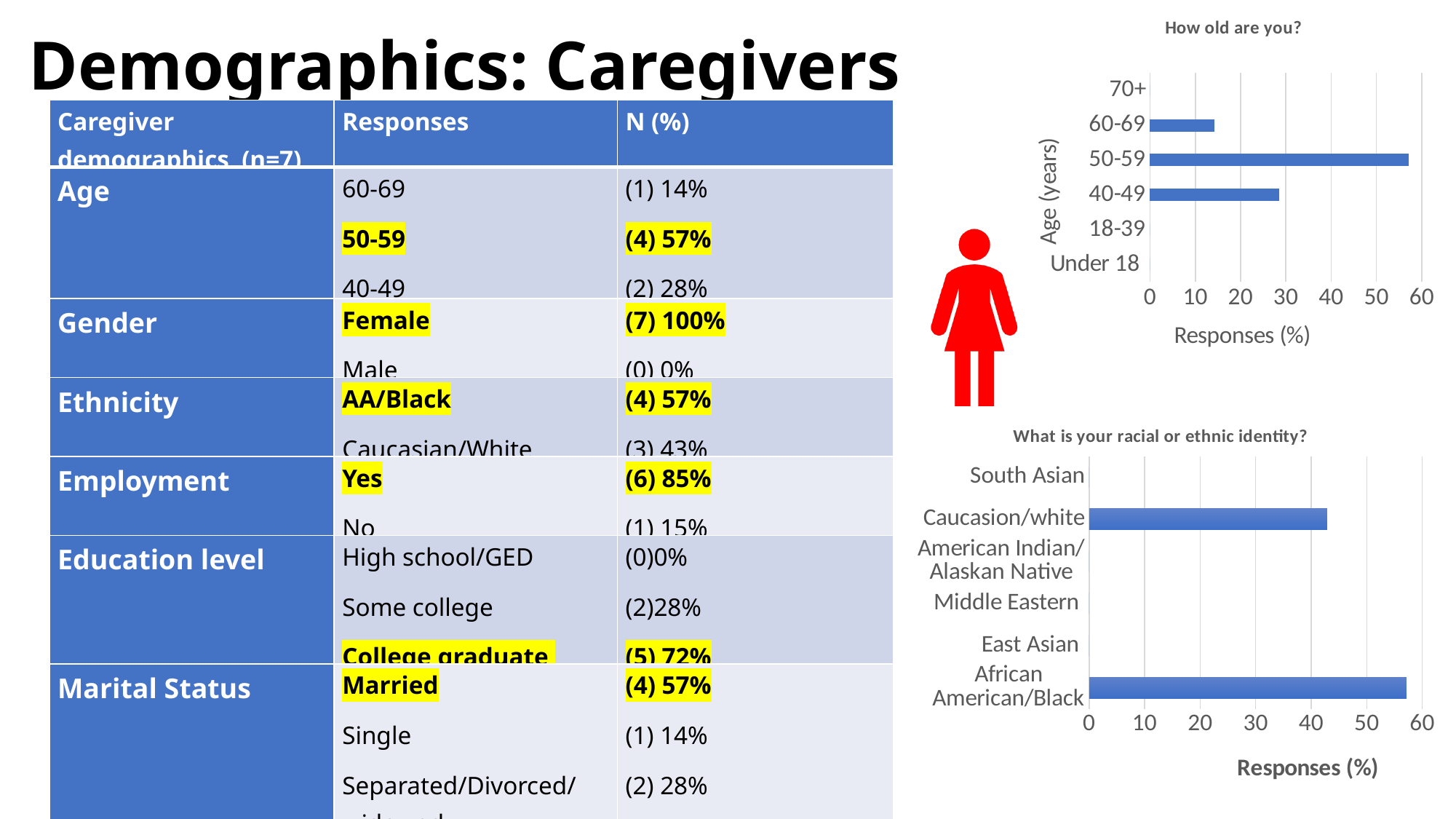
In the 'What is your racial or ethnic identity?' chart, is the value for Caucasion/white greater or less than 40? greater In the 'How old are you?' chart, is the value for 40-49 greater or less than 20? greater How many categories are listed on the axis of the 'What is your racial or ethnic identity?' chart? 6 In the 'How old are you?' chart, is the value for 60-69 greater or less than 20? less In the 'How old are you?' chart, which is larger, the value for 40-49 or the value for 60-69? 40-49 How many age categories are listed on the axis of the 'How old are you?' chart? 6 What kind of chart is the 'How old are you?' chart? bar chart In the 'What is your racial or ethnic identity?' chart, which category has the highest response percentage? African American/Black In the 'How old are you?' chart, which age group has the highest response percentage? 50-59 What is the x-axis label of the 'What is your racial or ethnic identity?' chart? Responses (%)